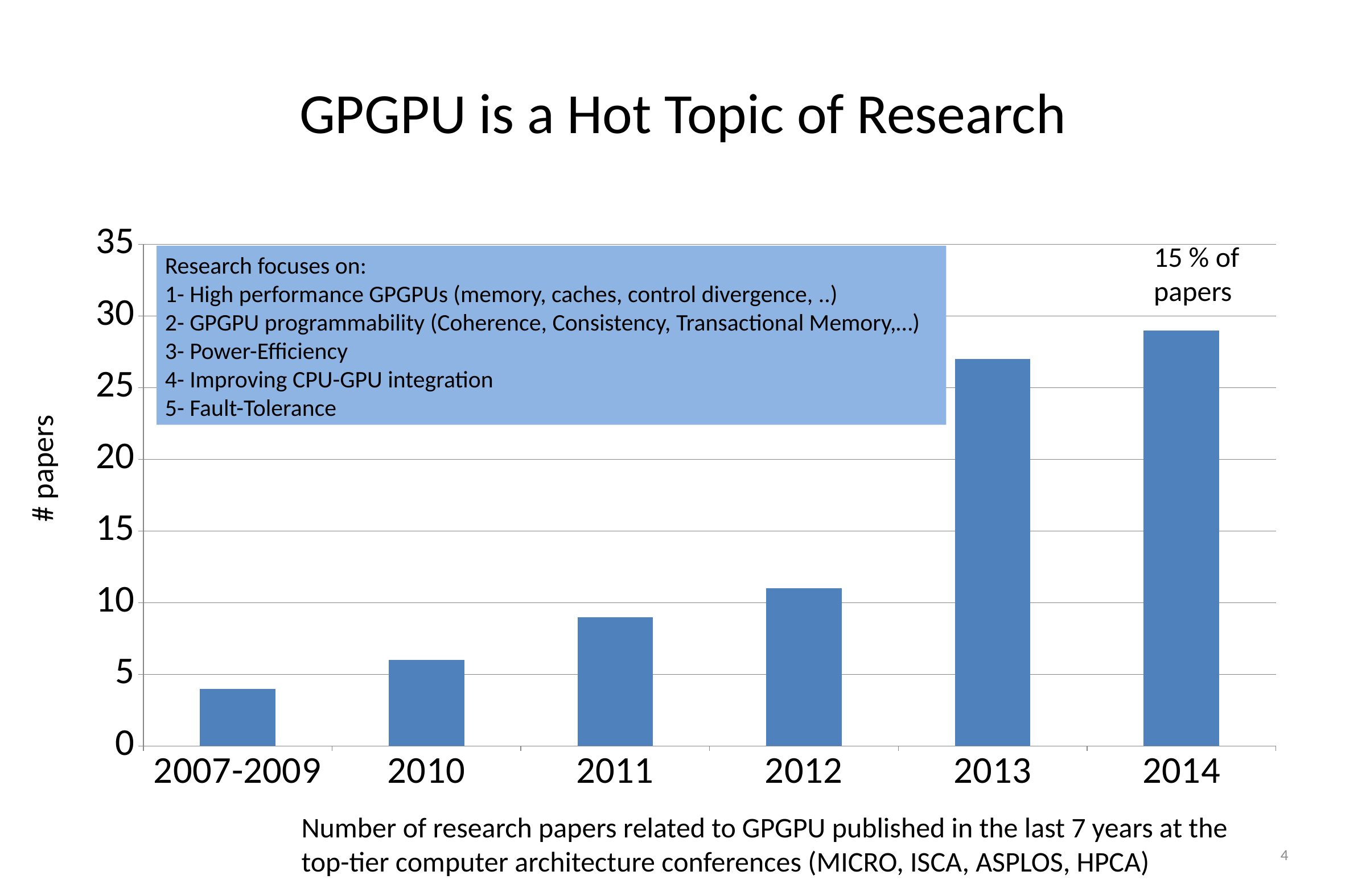
Is the value for 2014 greater or less than 25? greater Is the value for 2007-2009 greater or less than 5? less Which has more papers, 2013 or 2012? 2013 Which category has the highest number of papers? 2014 What kind of chart is shown on the slide? bar chart What is the label on the y axis of the chart? # papers Do the values rise or fall from 2007-2009 to 2014? rise How many categories are shown on the x axis of the chart? 6 Is the value for 2013 greater or less than 30? less What annotation is printed above the 2014 bar? 15 % of papers Which category has the lowest number of papers? 2007-2009